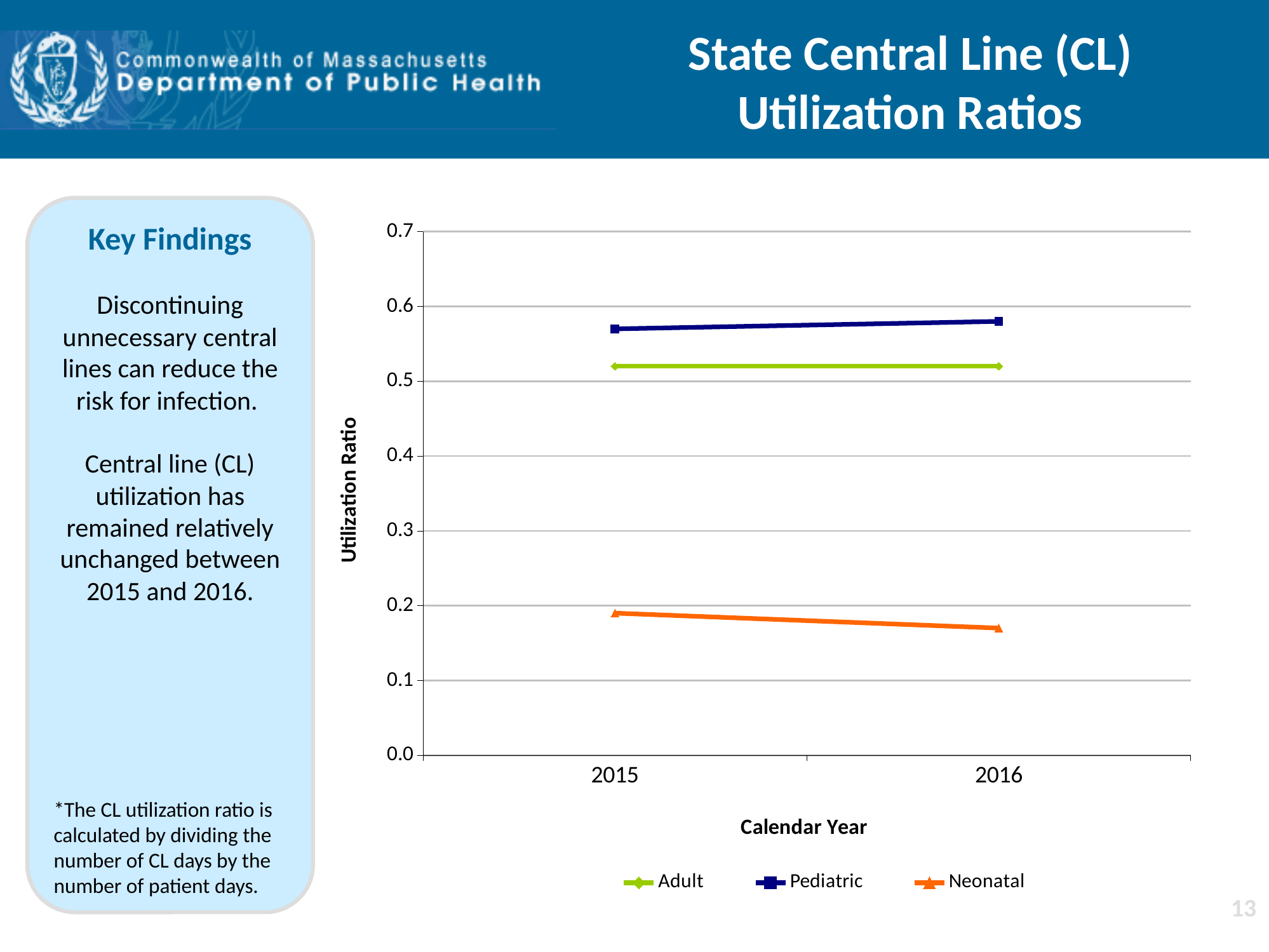
What kind of chart is shown on the slide? line chart How many calendar years are plotted on the x axis? 2 Which series has the highest utilization ratio in 2016? Pediatric Which is larger in 2015, the Pediatric or the Adult utilization ratio? Pediatric What is the label of the y axis? Utilization Ratio Does the Neonatal utilization ratio rise or fall from 2015 to 2016? fall Which series has the lowest utilization ratio in 2015? Neonatal Which is larger in 2016, the Adult or the Neonatal utilization ratio? Adult How many series does the legend list? 3 Is the Neonatal utilization ratio in 2016 greater or less than 0.2? less Is the Adult utilization ratio in 2015 greater or less than 0.5? greater Is the Pediatric utilization ratio in 2016 greater or less than 0.6? less